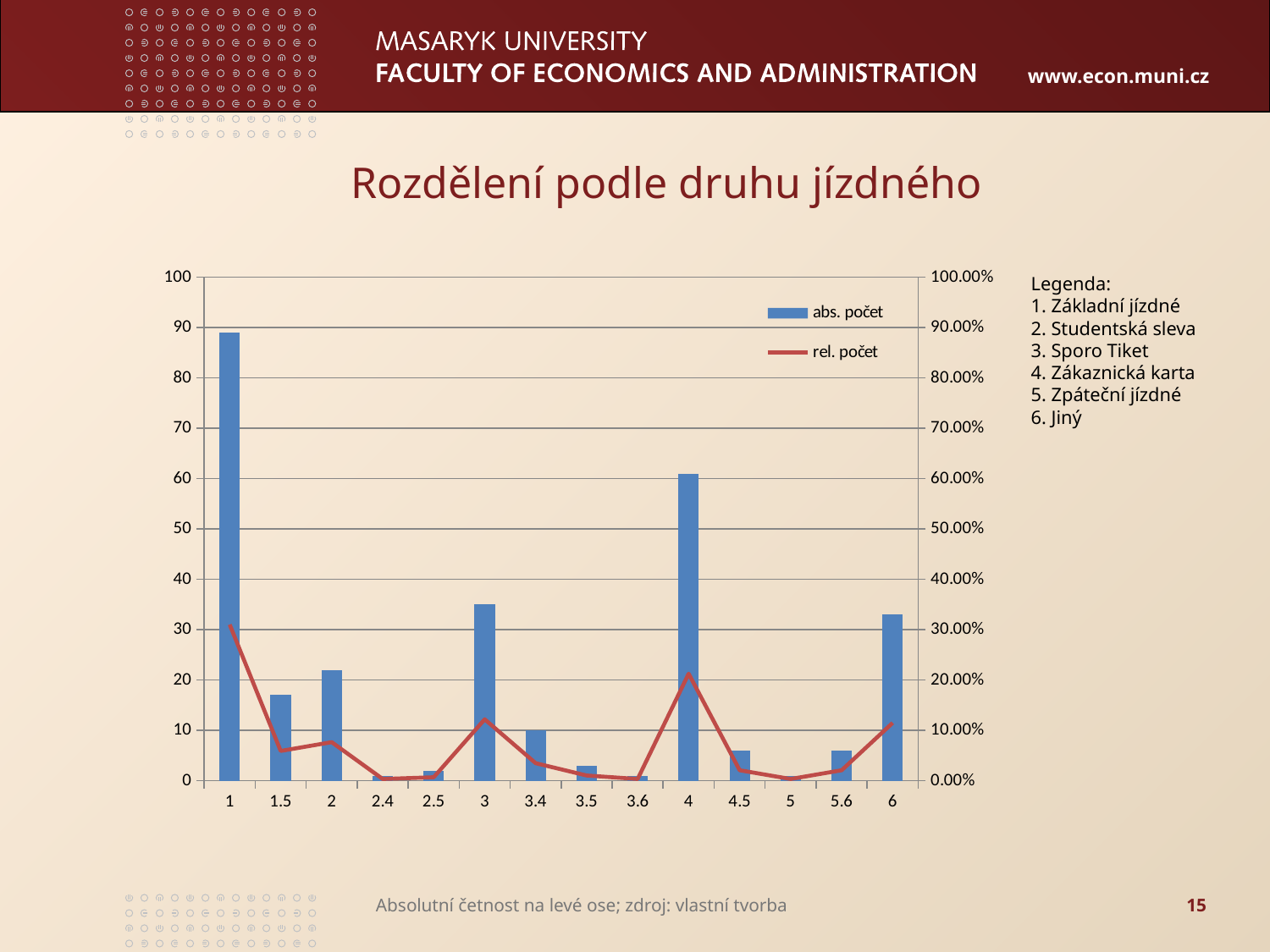
Which has a larger abs. počet bar, category 2 or category 4? 4 How many series does the chart legend list? 2 Is the abs. počet value for category 6 greater or less than 30? greater Which series is drawn as a red line in the chart? rel. počet Is the abs. počet value for category 1.5 greater or less than 20? less Which category has the highest abs. počet bar? 1 Which has a larger abs. počet bar, category 3 or category 6? 3 How many categories are shown along the x axis of the chart? 14 Is the abs. počet value for category 1 greater or less than 80? greater What is the title of the chart? Rozdělení podle druhu jízdného What kind of chart is shown on the slide? bar chart with a line